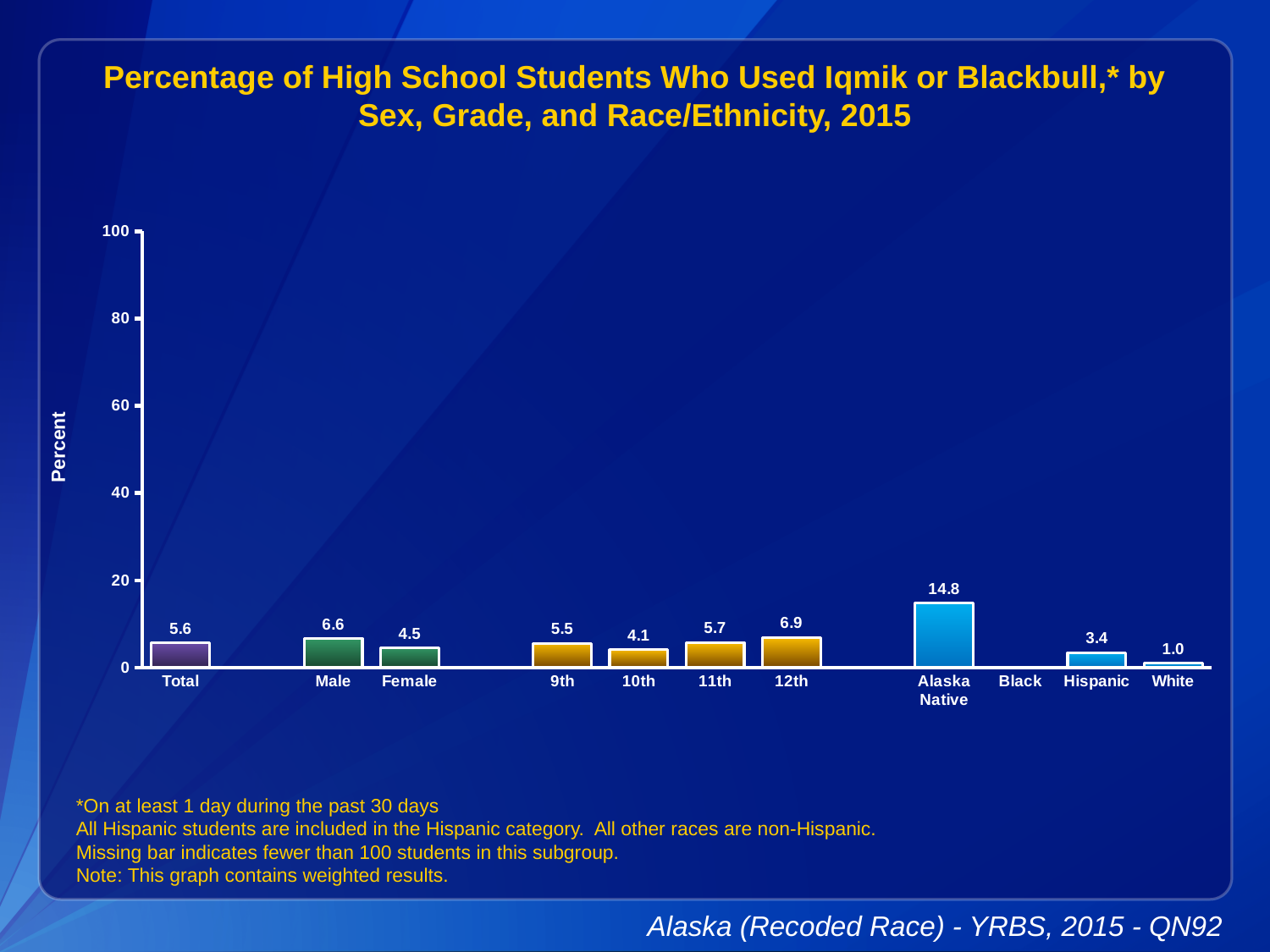
Which category has the highest value? Alaska Native Do the values rise or fall from 10th grade to 12th grade? rise What is the difference between the Male and Female values? 2.1 What is the value for 10th grade? 4.1 Which category has no bar shown? Black What is the value for Total? 5.6 How many categories have a plotted bar? 11 Which category with a plotted bar has the lowest value? White What is the value for Alaska Native? 14.8 What kind of chart is shown? bar chart Is the value for Alaska Native greater or less than 20? less Which is larger, the value for 12th grade or the value for 9th grade? 12th